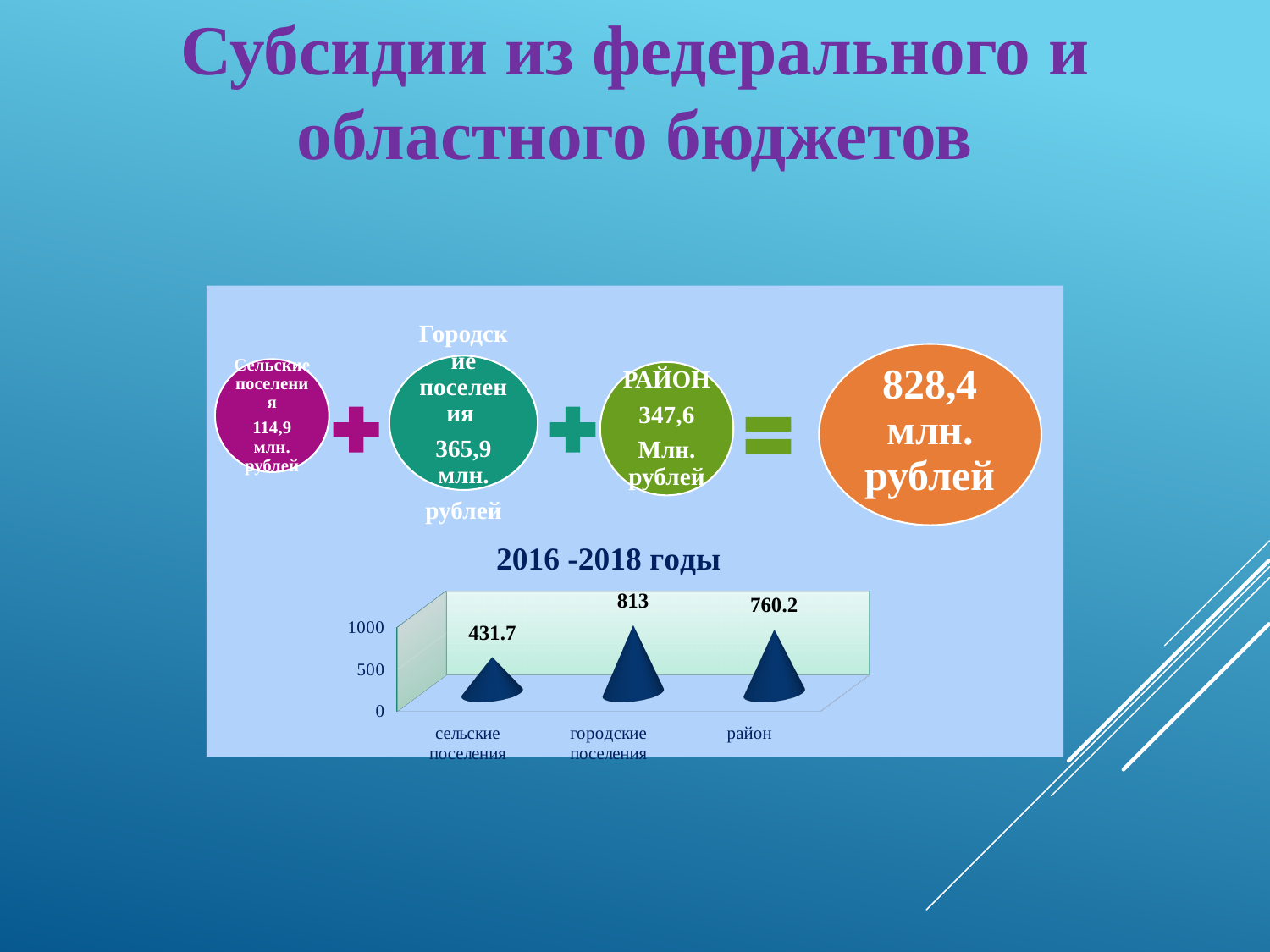
In the chart titled "2016 -2018 годы", what is the value for сельские поселения? 431.7 In the chart titled "2016 -2018 годы", how many categories are shown on the x axis? 3 In the chart titled "2016 -2018 годы", what is the difference between the values for район and сельские поселения? 328.5 In the chart titled "2016 -2018 годы", what is the difference between the values for городские поселения and район? 52.8 In the chart titled "2016 -2018 годы", what is the value for район? 760.2 In the chart titled "2016 -2018 годы", what is the value for городские поселения? 813 What is the title of the chart at the bottom of the slide? 2016 -2018 годы What kind of chart is the chart titled "2016 -2018 годы"? bar chart In the chart titled "2016 -2018 годы", which category has the lowest value? сельские поселения In the chart titled "2016 -2018 годы", is the value for сельские поселения greater or less than 500? less In the chart titled "2016 -2018 годы", which is larger: the value for сельские поселения or the value for район? район In the chart titled "2016 -2018 годы", which category has the highest value? городские поселения